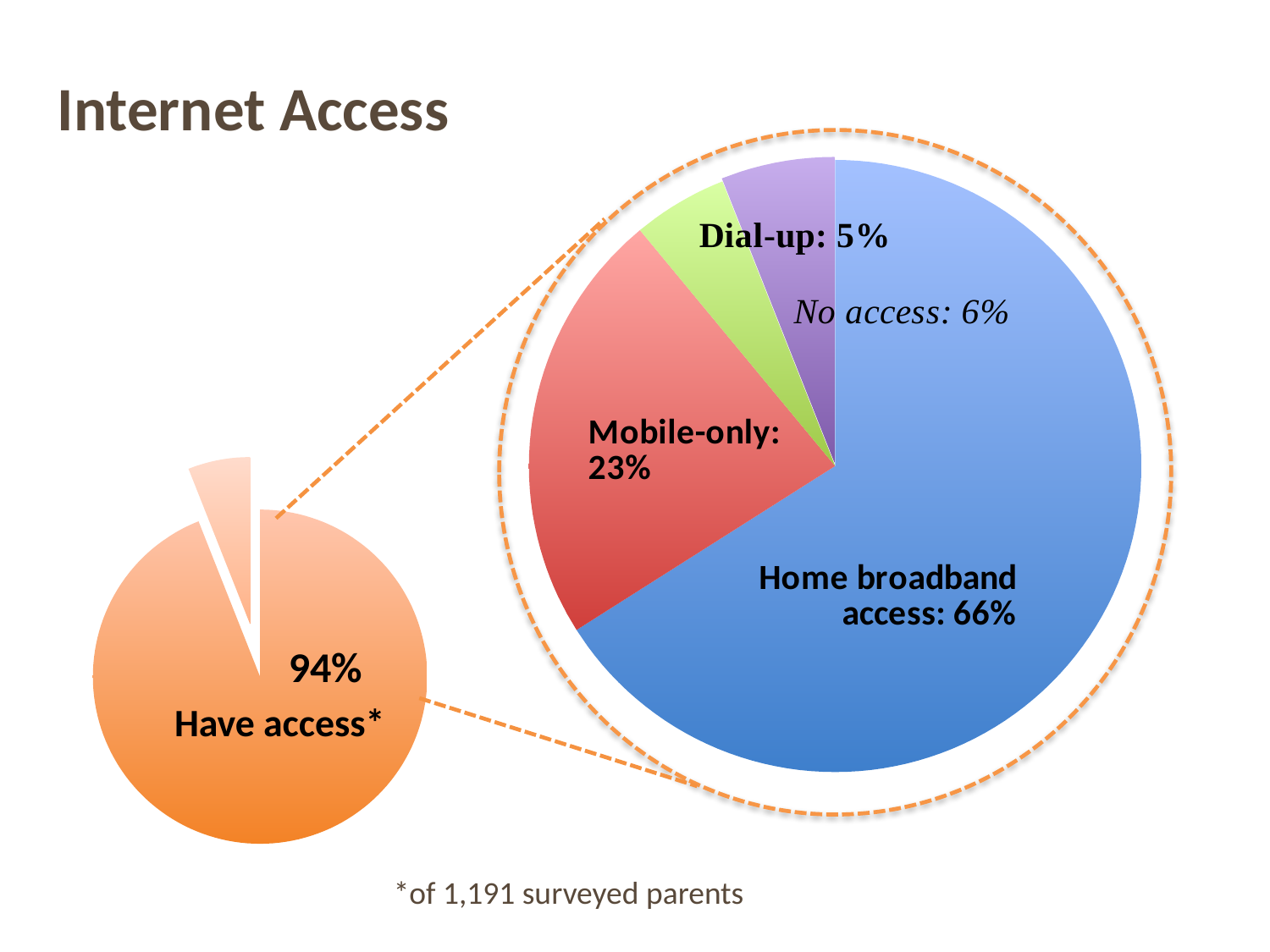
In the large pie chart on the right, what is the difference between the Home broadband access and Mobile-only percentages? 43% In the large pie chart on the right, which slice is the smallest? Dial-up In the large pie chart on the right, what percentage is labelled for Home broadband access? 66% In the large pie chart on the right, which slice is the largest? Home broadband access In the large pie chart on the right, what percentage is labelled for No access? 6% According to the footnote, how many parents were surveyed? 1,191 In the large pie chart on the right, which is larger, Mobile-only or No access? Mobile-only In the large pie chart on the right, what percentage is labelled for Dial-up? 5% What kind of chart is the large chart on the right? Pie chart How many slices does the large pie chart on the right have? 4 In the large pie chart on the right, what percentage is labelled for Mobile-only? 23% In the small pie chart on the left, what percentage is labelled for Have access? 94%